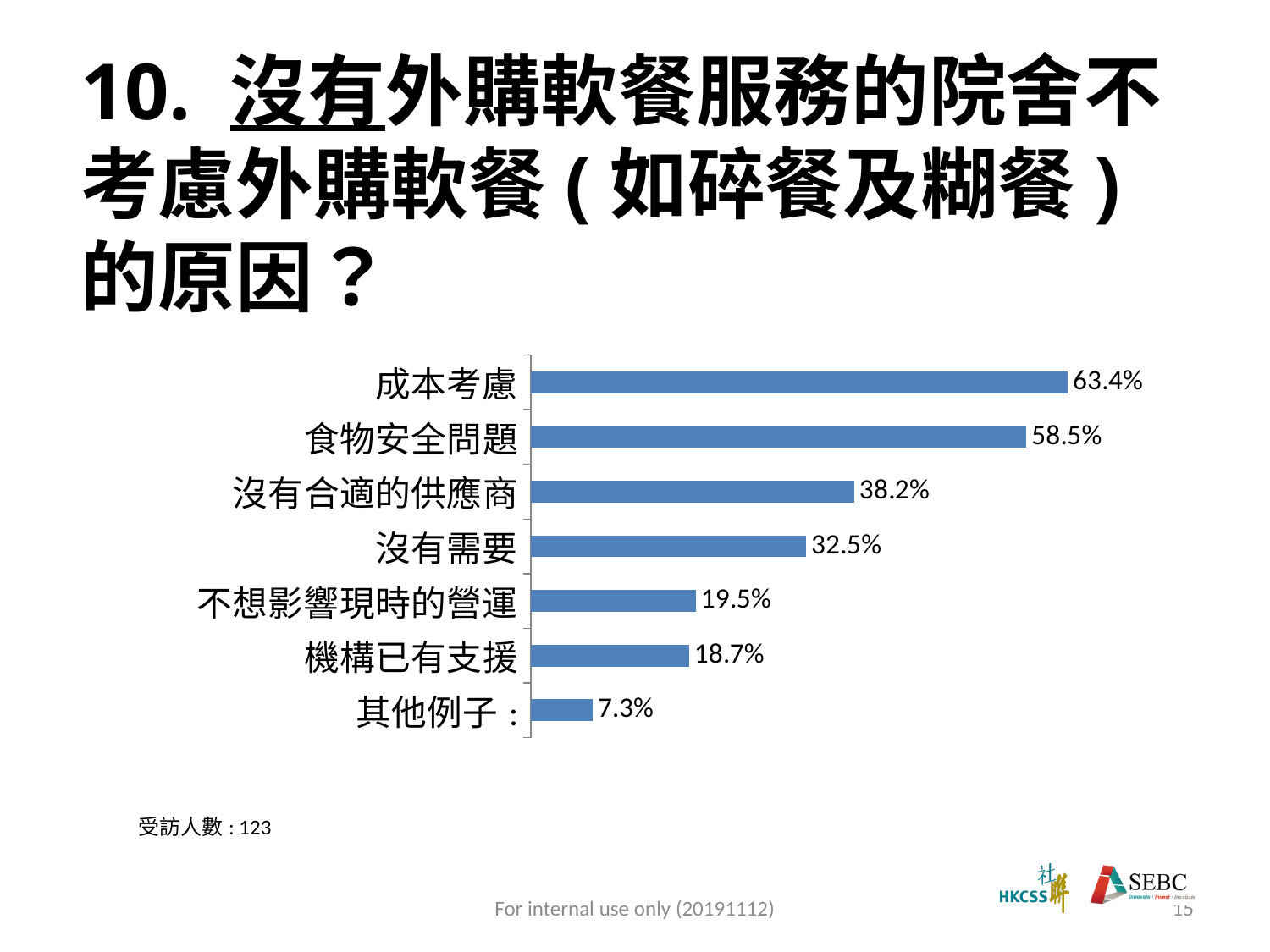
What is the number of respondents (受訪人數) stated below the chart? 123 Which category has the lowest value? 其他例子 Which category has the highest value? 成本考慮 What colour are the bars in the chart? Blue What is the value for 沒有合適的供應商? 38.2% What is the difference between the values for 成本考慮 and 食物安全問題? 4.9% Which is larger, the value for 不想影響現時的營運 or the value for 機構已有支援? 不想影響現時的營運 What is the difference between the values for 沒有合適的供應商 and 沒有需要? 5.7% What kind of chart is shown on the slide? Bar chart What is the value for 機構已有支援? 18.7% What is the value for 成本考慮? 63.4% How many categories are shown in the chart? 7